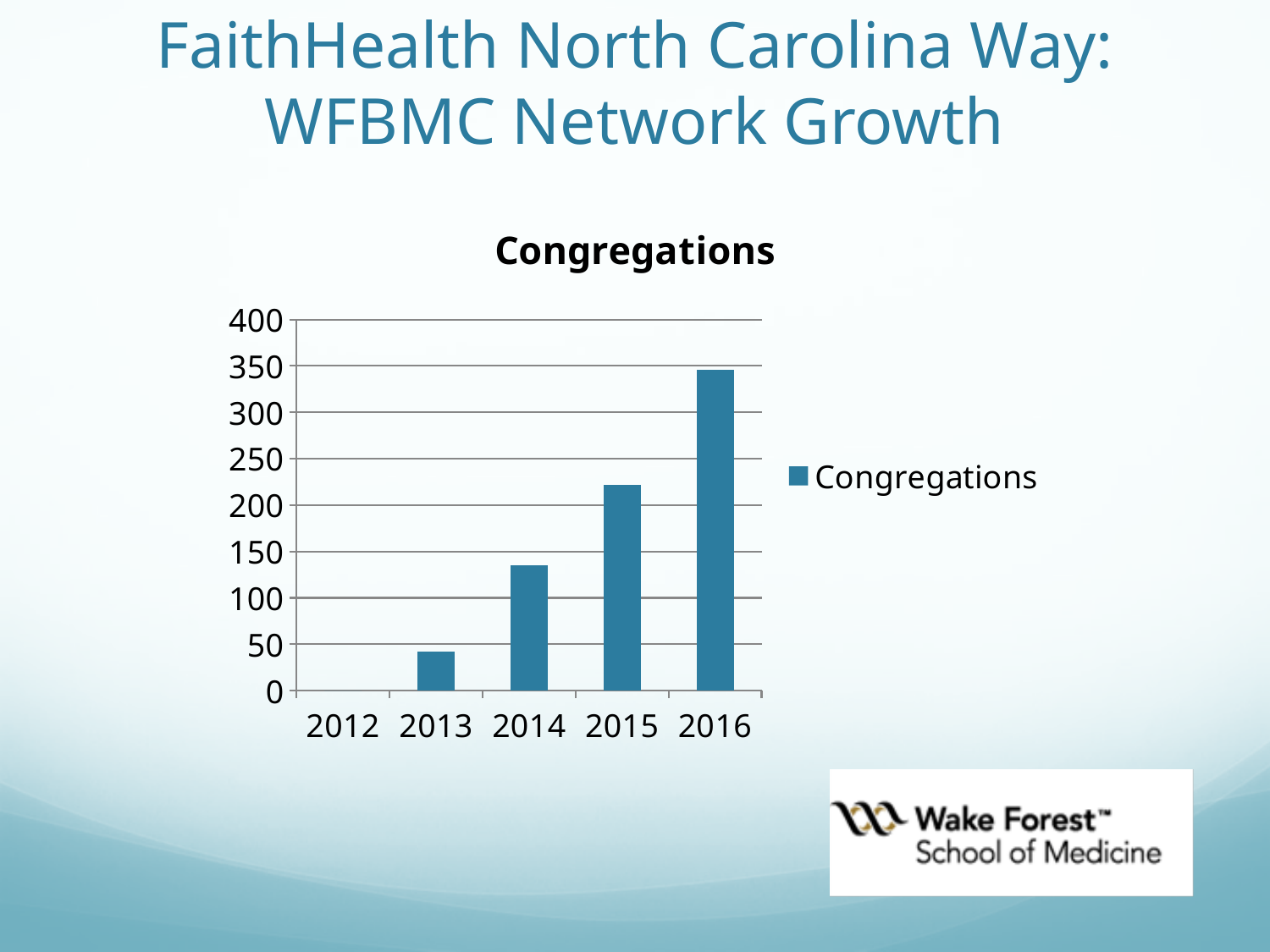
What kind of chart is shown on the slide? bar chart Which year has the lowest number of congregations? 2012 Is the value for 2016 greater or less than 300? greater How many series does the legend list? 1 Which year has more congregations, 2014 or 2015? 2015 Is the value for 2015 greater or less than 200? greater Do the values rise or fall from 2012 to 2016? rise How many years are shown on the x axis of the chart? 5 Is the value for 2013 greater or less than 50? less What is the title of the chart? Congregations Which year has the highest number of congregations? 2016